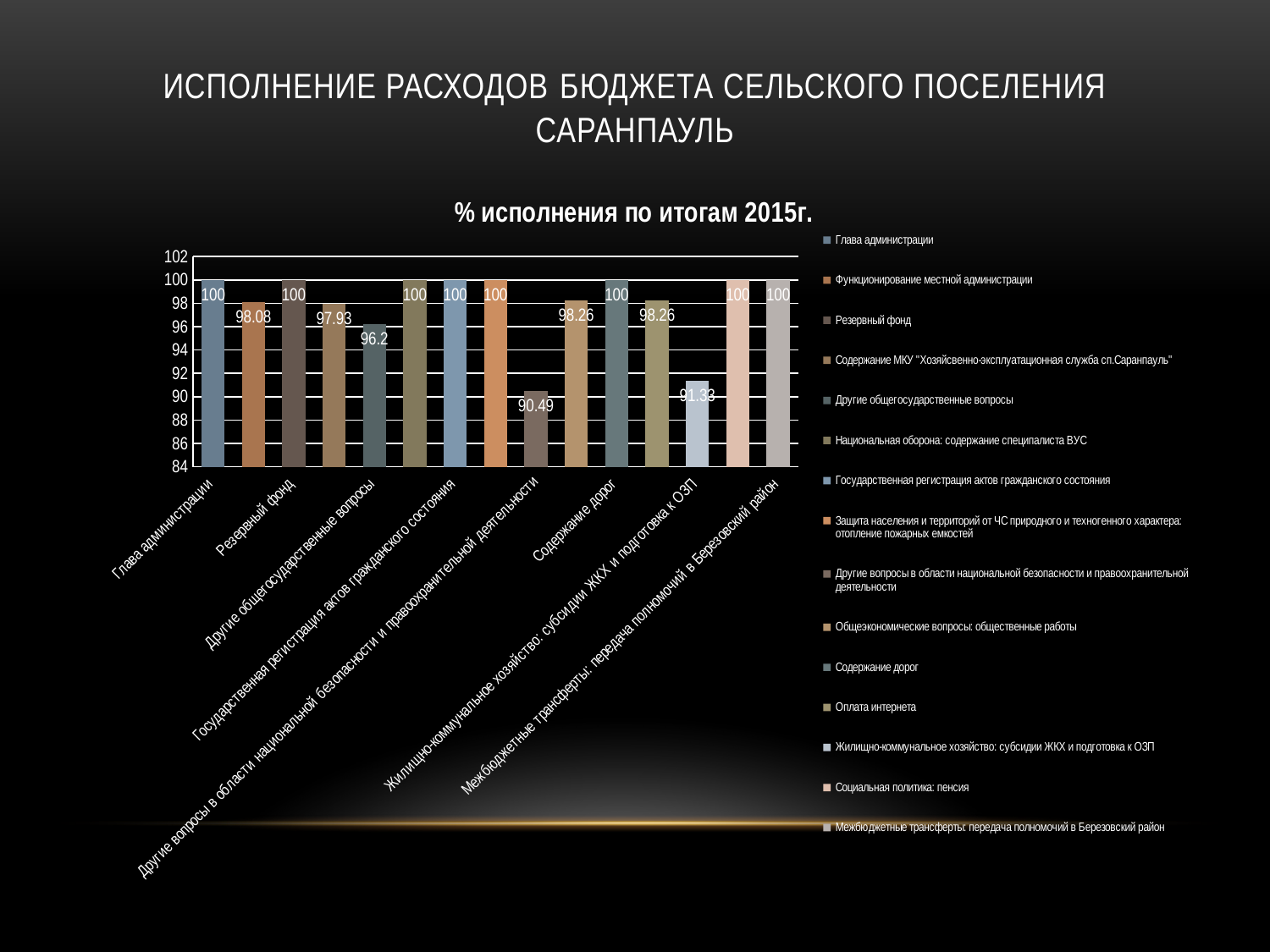
What is the chart's title? % исполнения по итогам 2015г. What is the value for Жилищно-коммунальное хозяйство: субсидии ЖКХ и подготовка к ОЗП? 91.33 Which is larger, the value for Содержание МКУ "Хозяйсвенно-эксплуатационная служба сп.Саранпауль" or the value for Другие общегосударственные вопросы? Содержание МКУ "Хозяйсвенно-эксплуатационная служба сп.Саранпауль" What is the value for Оплата интернета? 98.26 What is the difference between the values for Глава администрации and Другие вопросы в области национальной безопасности и правоохранительной деятельности? 9.51 What is the value for Социальная политика: пенсия? 100 How many bars are plotted in the chart? 15 Which category has the lowest value? Другие вопросы в области национальной безопасности и правоохранительной деятельности What is the value for Функционирование местной администрации? 98.08 What type of chart is shown on the slide? bar chart What is the value for Другие общегосударственные вопросы? 96.2 How many entries does the legend list? 15